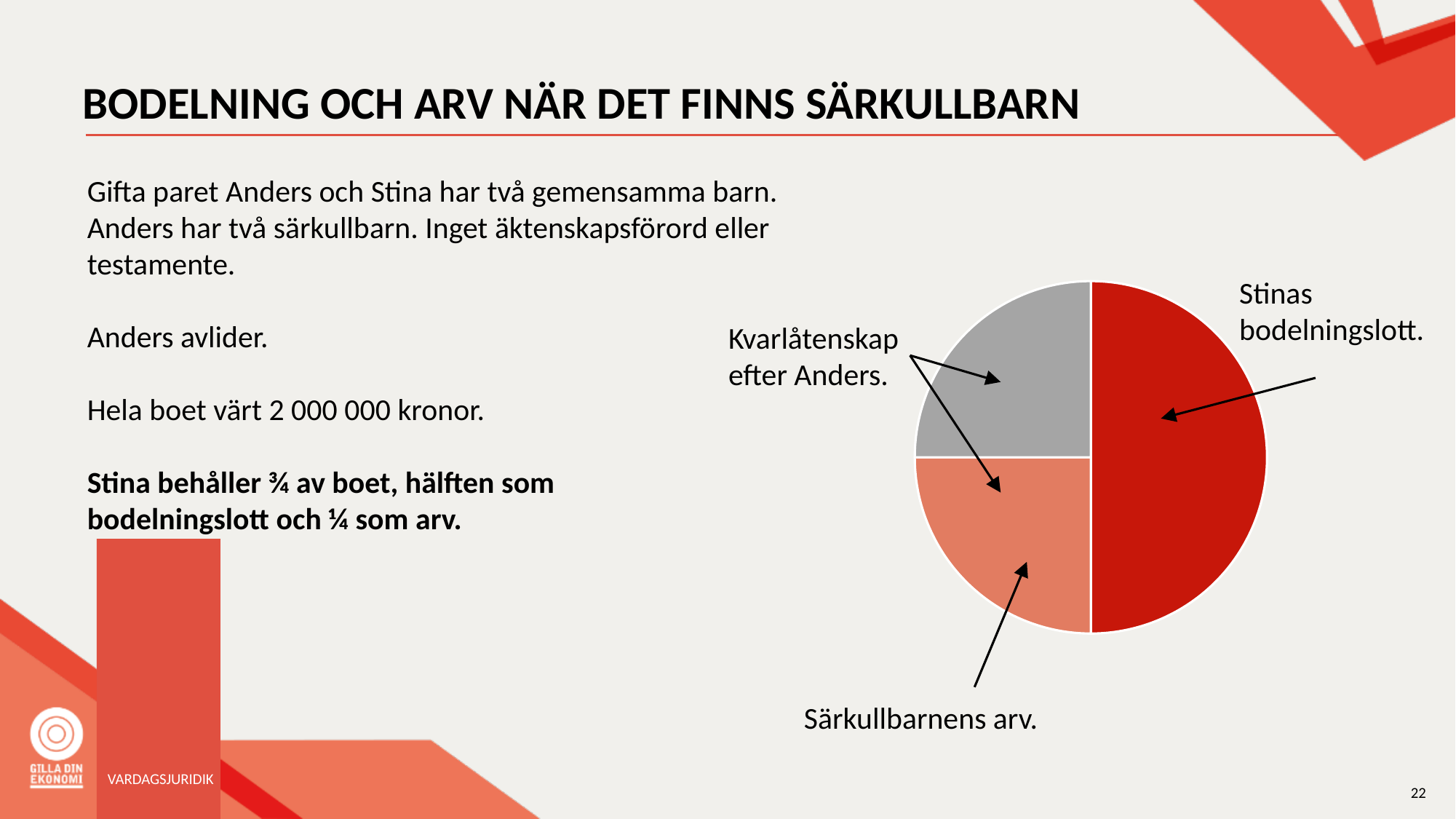
Which is larger in the pie chart, Stinas bodelningslott or Särkullbarnens arv? Stinas bodelningslott What share of the pie does Stinas bodelningslott take up? hälften (half) What colour is the slice labelled Stinas bodelningslott? red What kind of chart is shown on the slide? pie chart Which slice of the pie chart is the largest? Stinas bodelningslott How many slices does the pie chart have? 3 What colour is the slice labelled Kvarlåtenskap efter Anders? grey Which is larger in the pie chart, Stinas bodelningslott or Kvarlåtenskap efter Anders? Stinas bodelningslott